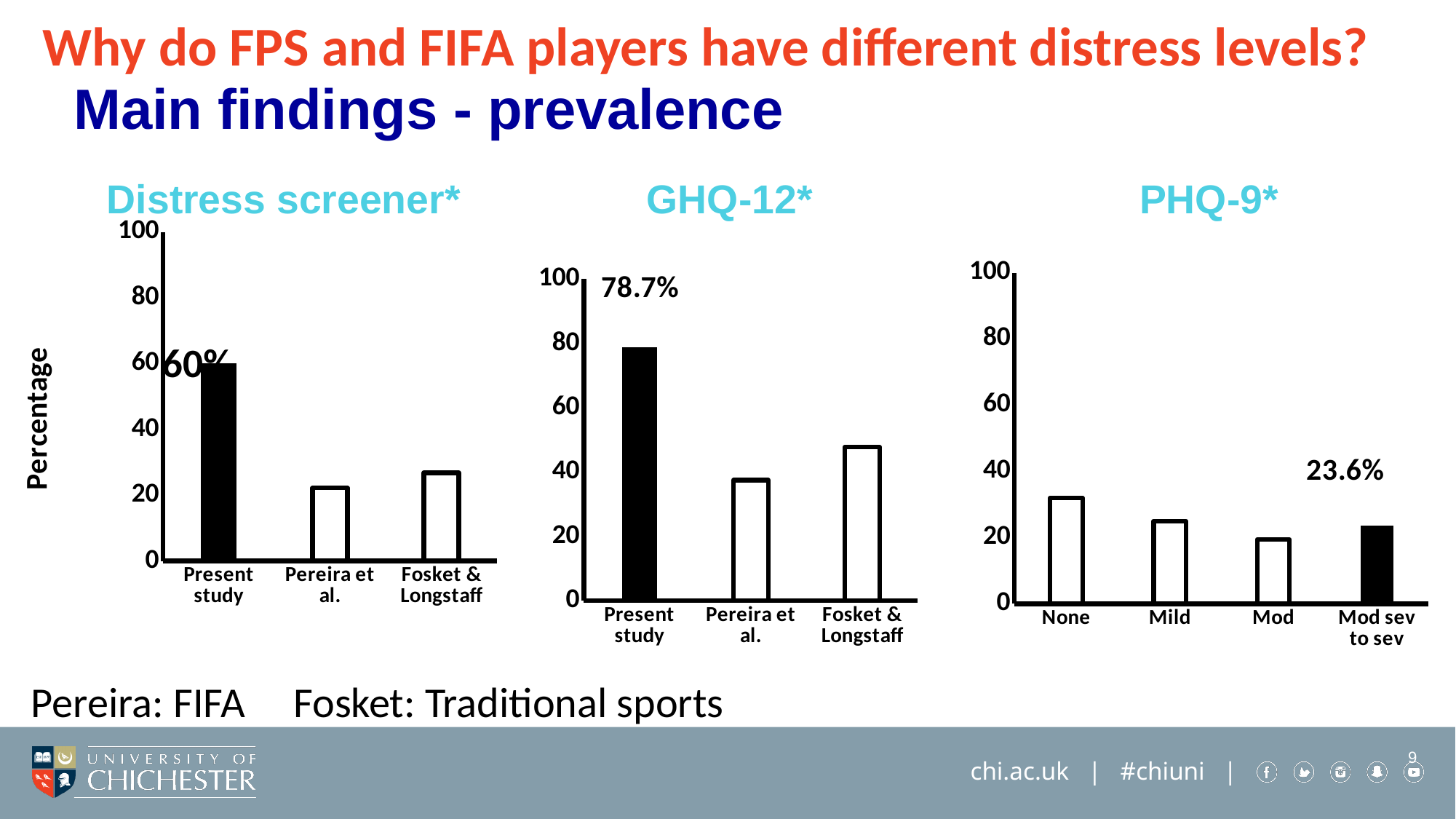
In the GHQ-12* chart, what is the value for Present study? 78.7% In the PHQ-9* chart, which category has the highest value? None In the GHQ-12* chart, is the value for Pereira et al. greater or less than 40? less How many categories are shown in the PHQ-9* chart? 4 In the PHQ-9* chart, what is the value for Mod sev to sev? 23.6% In the Distress screener* chart, which category has the lowest value? Pereira et al. In the Distress screener* chart, what is the value for Present study? 60% In the GHQ-12* chart, which is larger, Pereira et al. or Fosket & Longstaff? Fosket & Longstaff In the GHQ-12* chart, is the value for Fosket & Longstaff greater or less than 40? greater In the PHQ-9* chart, is the value for None greater or less than 20? greater What type of chart is the Distress screener* chart? Bar chart In the GHQ-12* chart, which category has the highest value? Present study